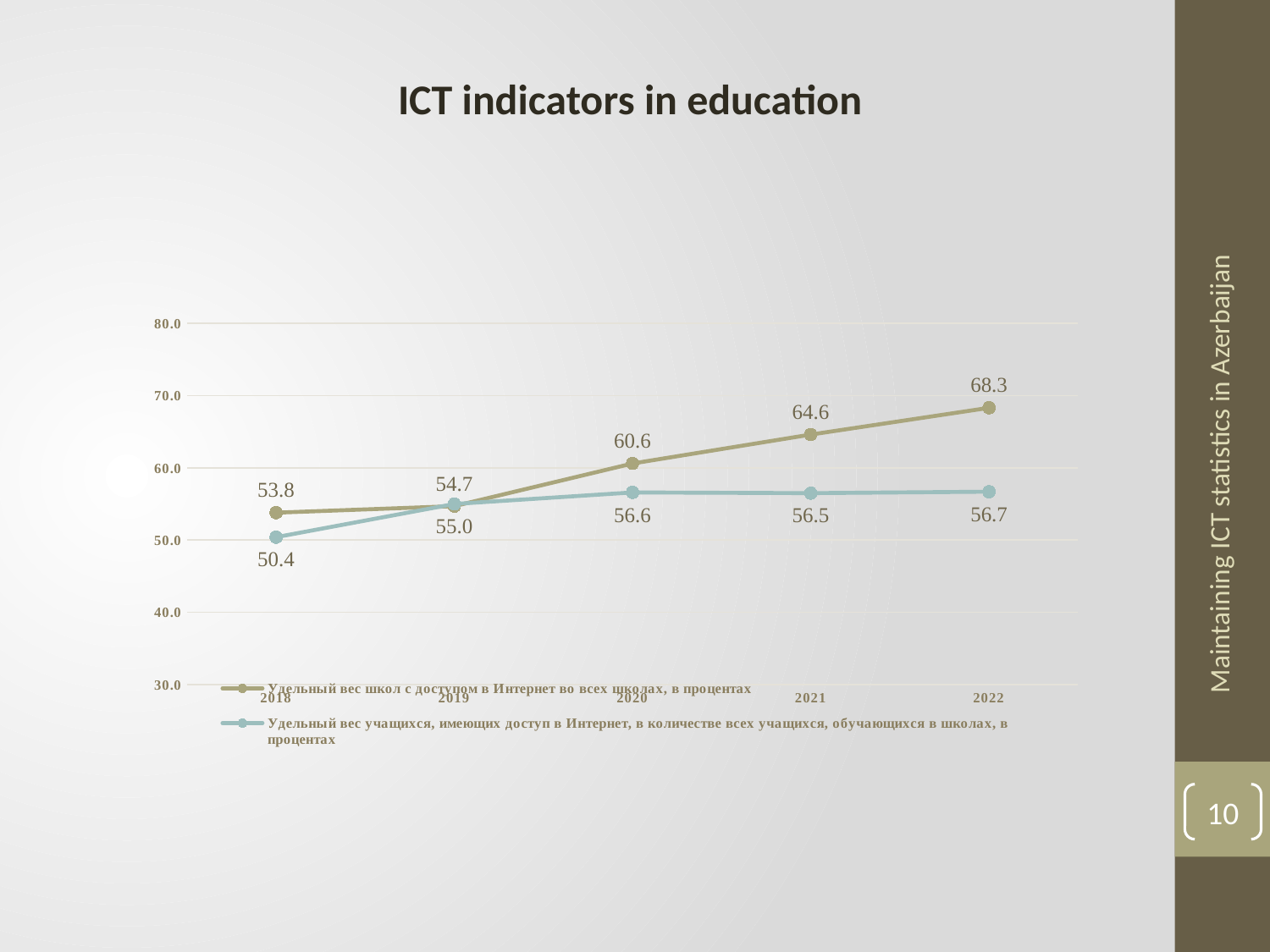
In which year does the blue line (share of students with Internet access) have its lowest value? 2018 What is the value of the blue line (share of students with Internet access) in 2021? 56.5 In 2019, which line has the higher value: the olive line (schools) or the blue line (students)? the blue line (students), 55.0 What is the value of the olive line (share of schools with Internet access) in 2022? 68.3 In which year does the olive line (share of schools with Internet access) reach its highest value? 2022 How many years are plotted on the x axis? 5 Does the olive line (share of schools with Internet access) rise or fall from 2018 to 2022? rise What is the difference between the olive line's value in 2022 and its value in 2018? 14.5 How many series does the legend list? 2 What type of chart is shown on the slide? line chart What is the value of the blue line (share of students with Internet access) in 2018? 50.4 What is the value of the olive line (share of schools with Internet access) in 2020? 60.6